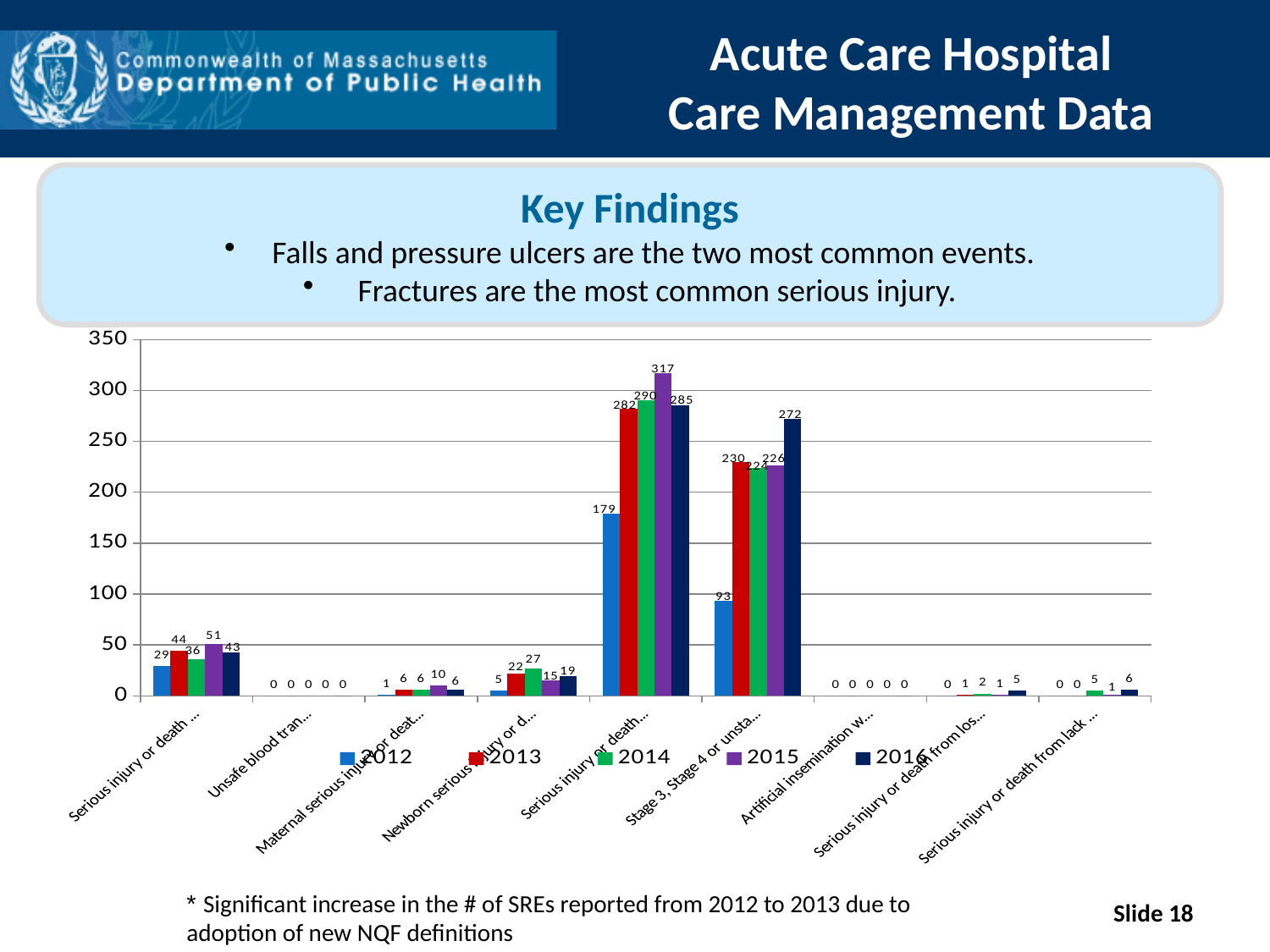
What is the 2015 value for the category labelled "Maternal serious injury or deat..."? 10 Is the 2016 value in the fifth category from the left (the tallest group of bars) greater or less than 250? greater What is the 2016 value for the category labelled "Unsafe blood tran..."? 0 How many categories are shown along the x axis? 9 For the category labelled "Stage 3, Stage 4 or unsta...", which year has the larger value, 2013 or 2014? 2013 How many series does the legend list? 5 What is the 2012 value for the category labelled "Newborn serious injury or d..."? 5 In the fifth category from the left (the tallest group of bars), which year has the highest value? 2015 What is the highest data label value shown anywhere on the chart? 317 What is the 2015 value for the category labelled "Stage 3, Stage 4 or unsta..."? 226 What type of chart is shown on the slide? bar chart For the category labelled "Stage 3, Stage 4 or unsta...", what is the difference between the 2016 value and the 2012 value? 179